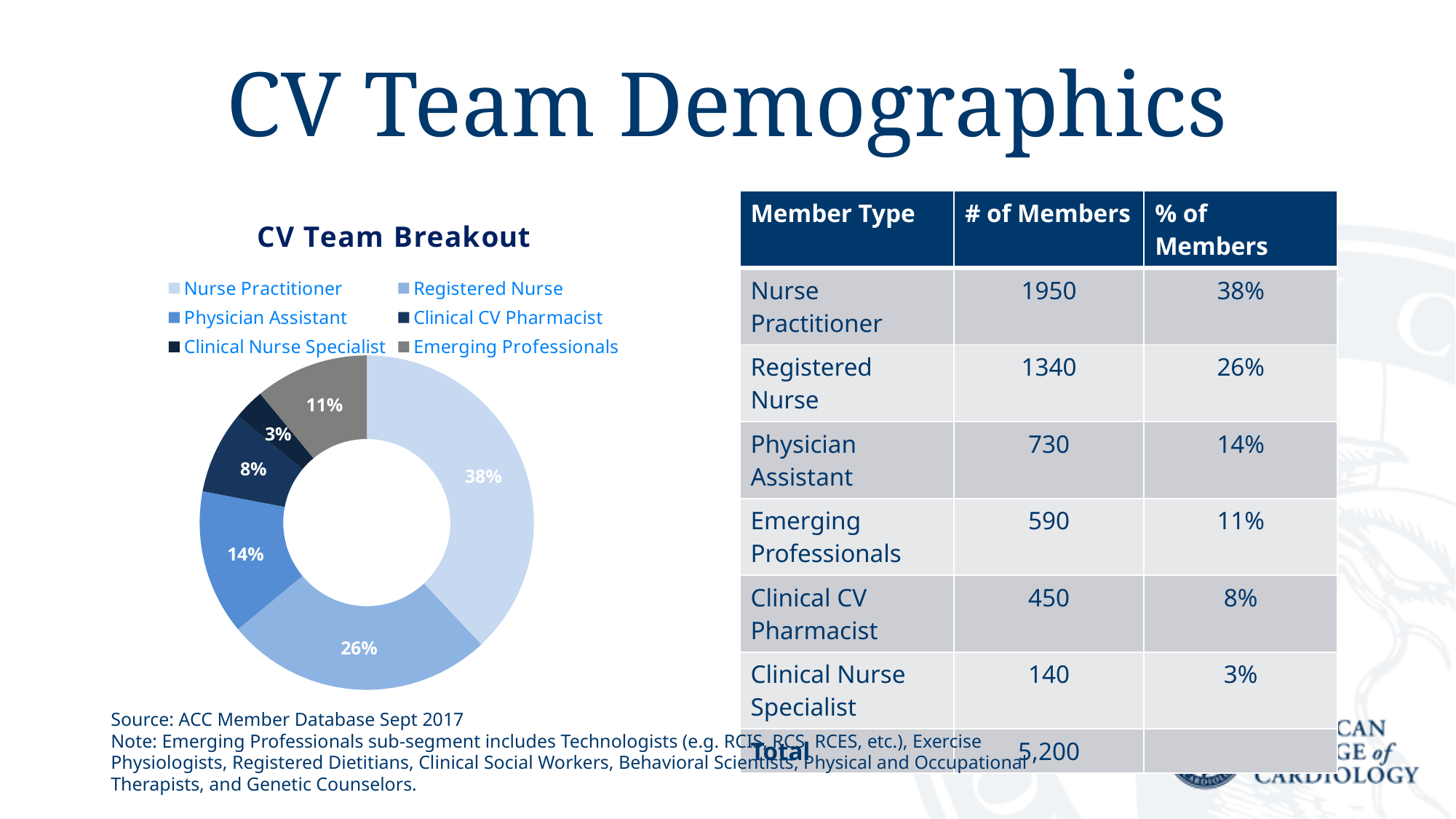
What is the title of the doughnut chart on the slide? CV Team Breakout Which category has the smallest slice in the CV Team Breakout chart? Clinical Nurse Specialist What kind of chart is the CV Team Breakout chart? Doughnut (pie) chart Which category has the largest slice in the CV Team Breakout chart? Nurse Practitioner In the CV Team Breakout chart, what is the difference in percentage points between Nurse Practitioner and Registered Nurse? 12 In the CV Team Breakout chart, what share is shown for Registered Nurse? 26% In the CV Team Breakout chart, what share is shown for Physician Assistant? 14% In the CV Team Breakout chart, which is larger: Clinical CV Pharmacist or Emerging Professionals? Emerging Professionals In the CV Team Breakout chart, what share is shown for Emerging Professionals? 11% How many categories does the legend of the CV Team Breakout chart list? 6 In the CV Team Breakout chart, what share is shown for Nurse Practitioner? 38% In the CV Team Breakout chart, what share is shown for Clinical Nurse Specialist? 3%